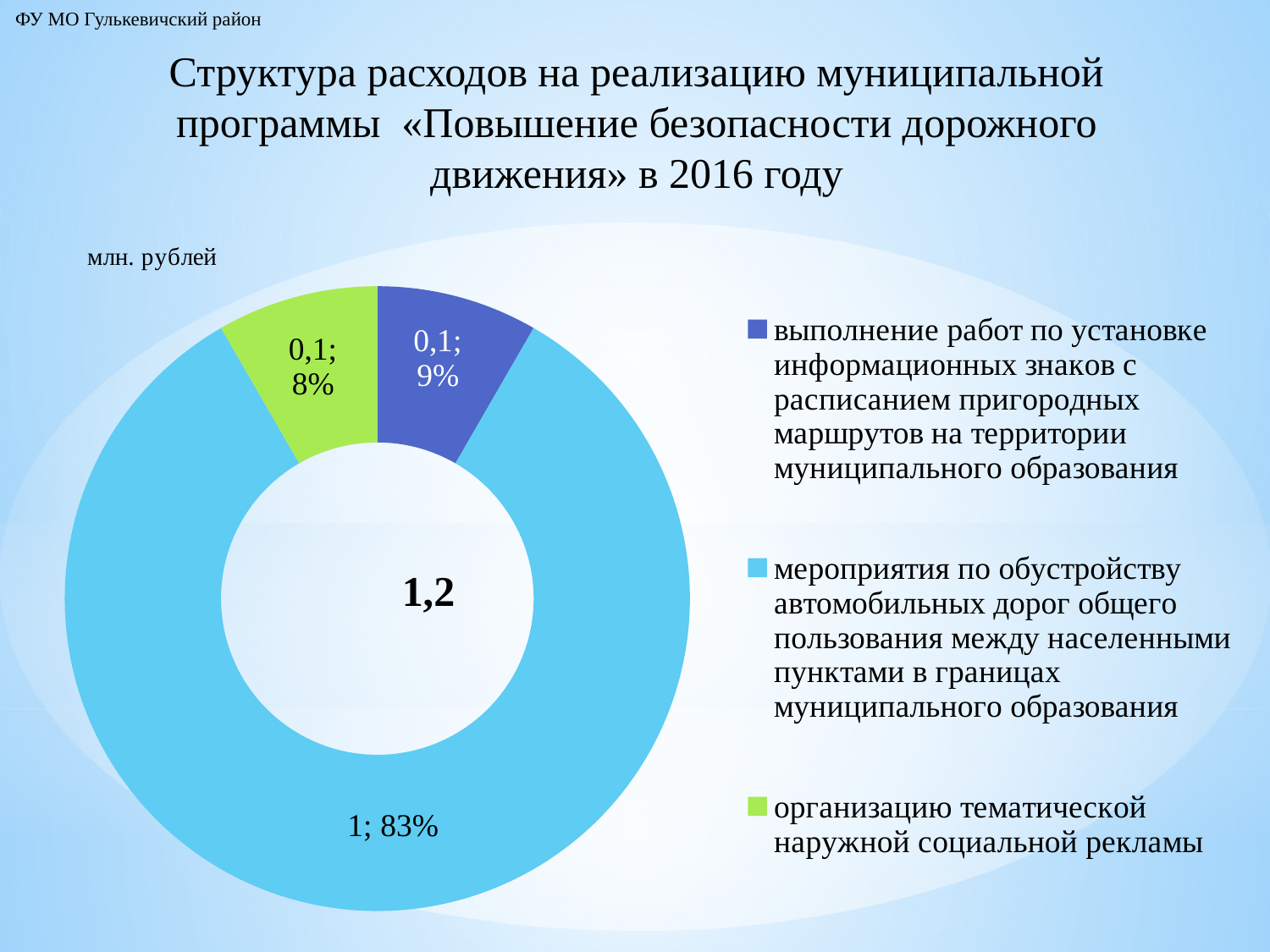
How many entries does the legend list? 3 What share of the doughnut does «выполнение работ по установке информационных знаков» take? 9% Which category has the largest slice of the doughnut? мероприятия по обустройству автомобильных дорог общего пользования между населенными пунктами в границах муниципального образования What total value is shown in the centre of the doughnut chart? 1,2 What kind of chart is shown on the slide? doughnut chart What is the value (in млн. рублей) for «выполнение работ по установке информационных знаков с расписанием пригородных маршрутов на территории муниципального образования»? 0,1 What share of the doughnut does «организацию тематической наружной социальной рекламы» take? 8% How many slices does the doughnut chart have? 3 What is the value (in млн. рублей) for «организацию тематической наружной социальной рекламы»? 0,1 What share of the doughnut does «мероприятия по обустройству автомобильных дорог общего пользования» take? 83% What unit of measurement is indicated above the chart? млн. рублей What is the value (in млн. рублей) for «мероприятия по обустройству автомобильных дорог общего пользования между населенными пунктами в границах муниципального образования»? 1